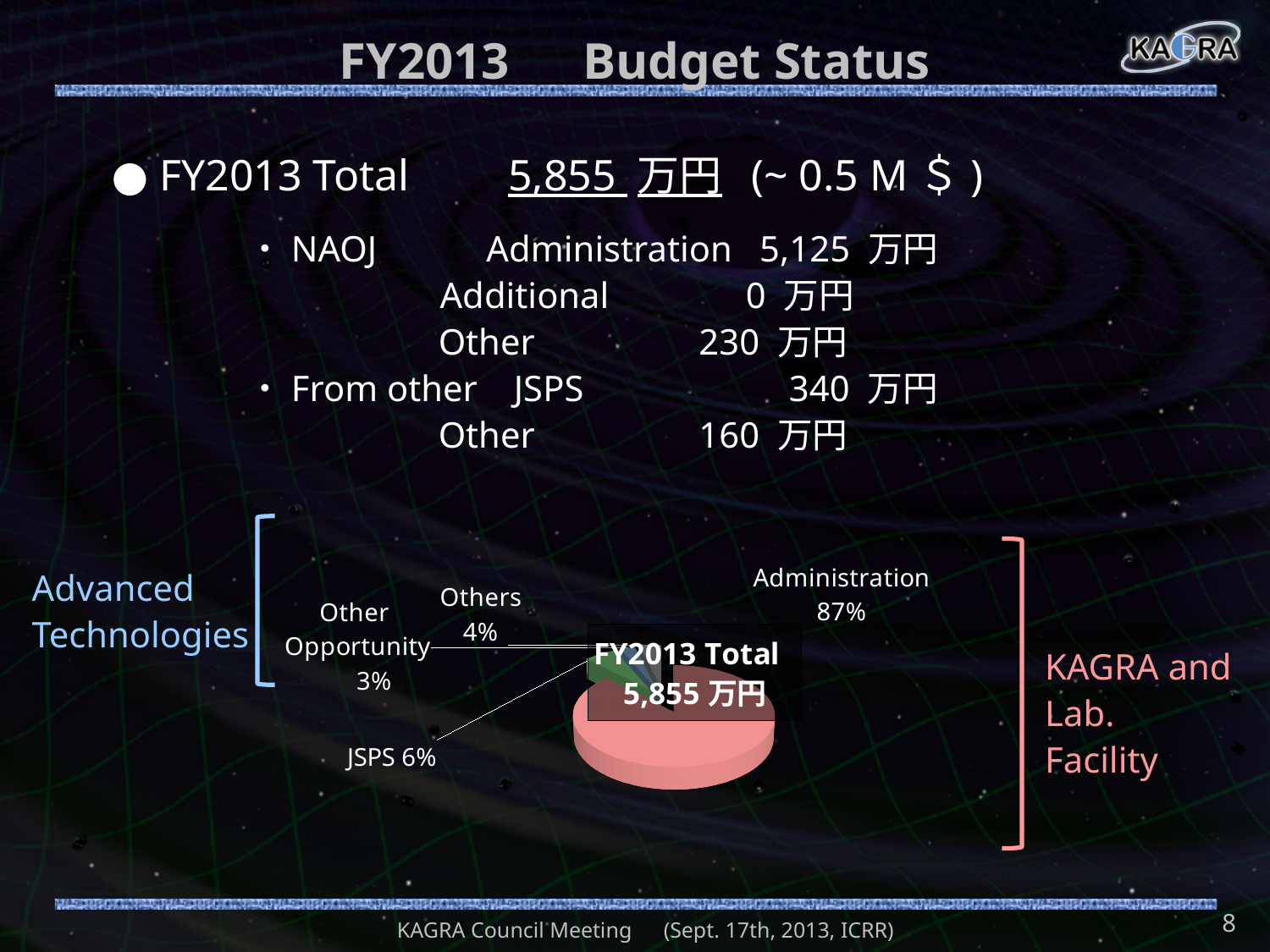
How many slices are labelled in the pie chart? 4 Which slice of the pie chart is the smallest? Other Opportunity What is the difference in percentage points between the Administration slice and the JSPS slice? 81 What share of the pie does Administration represent? 87% What share of the pie does Other Opportunity represent? 3% What is the combined share of the JSPS, Others and Other Opportunity slices? 13% What kind of chart is shown on the slide? pie chart Which is larger in the pie chart, JSPS or Others? JSPS What share of the pie does Others represent? 4% What share of the pie does JSPS represent? 6% What is the title shown on the pie chart? FY2013 Total 5,855 万円 Which slice of the pie chart is the largest? Administration